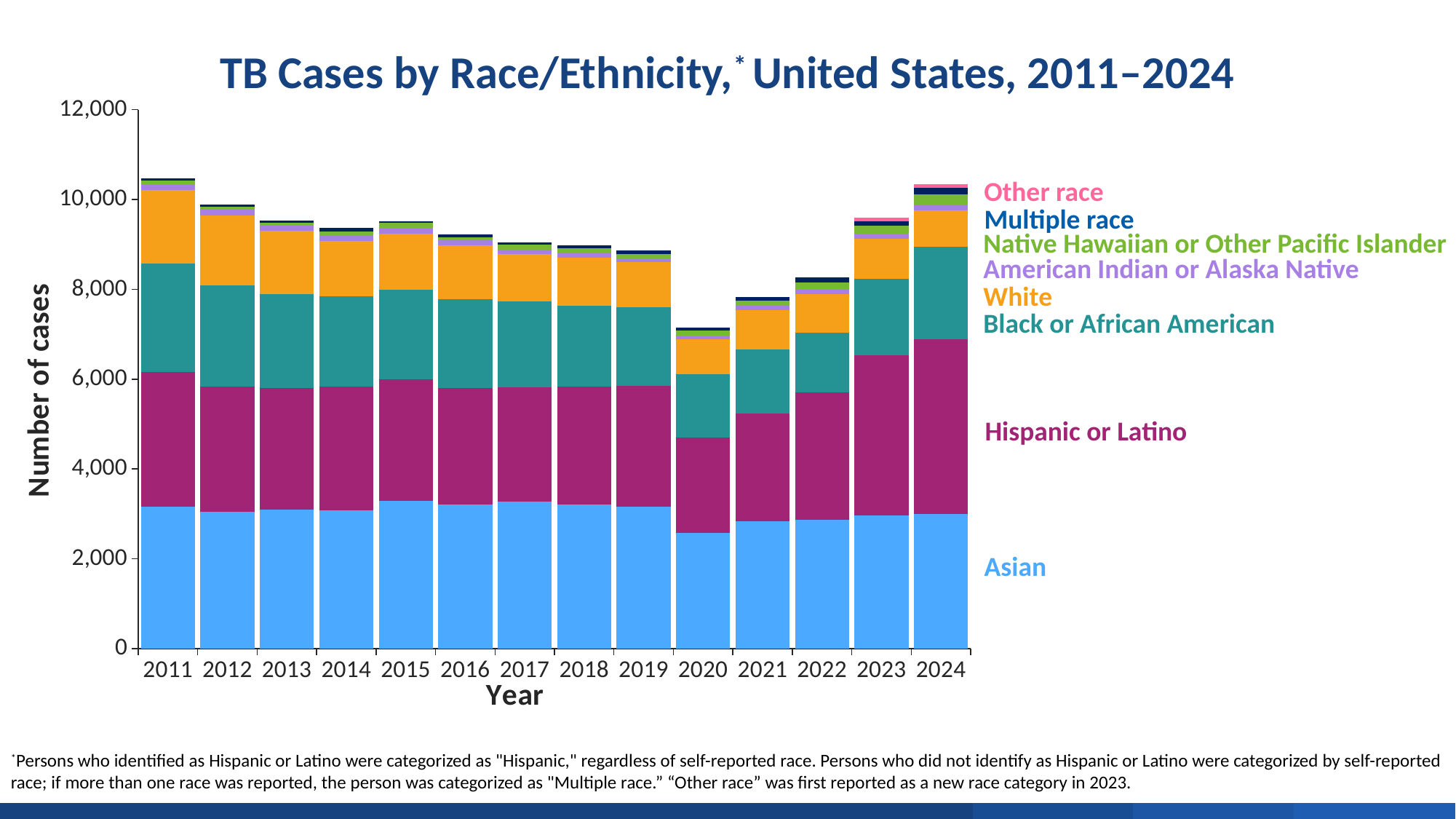
Which category forms the bottom segment of each stacked bar? Asian Which year has the lowest total number of TB cases? 2020 How many race/ethnicity categories does the legend list? 8 Is the total number of cases in 2023 greater or less than 9,000? greater Is the total number of cases in 2020 greater or less than 8,000? less What is the title of the chart? TB Cases by Race/Ethnicity, United States, 2011–2024 Which year has the larger total number of cases, 2019 or 2020? 2019 What kind of chart is shown on the slide? Stacked bar chart Do the total TB cases rise or fall from 2020 to 2024? Rise How many years (bars) are shown on the x axis? 14 Is the total number of cases in 2024 greater or less than 10,000? greater Do the total TB cases rise or fall from 2011 to 2020? Fall